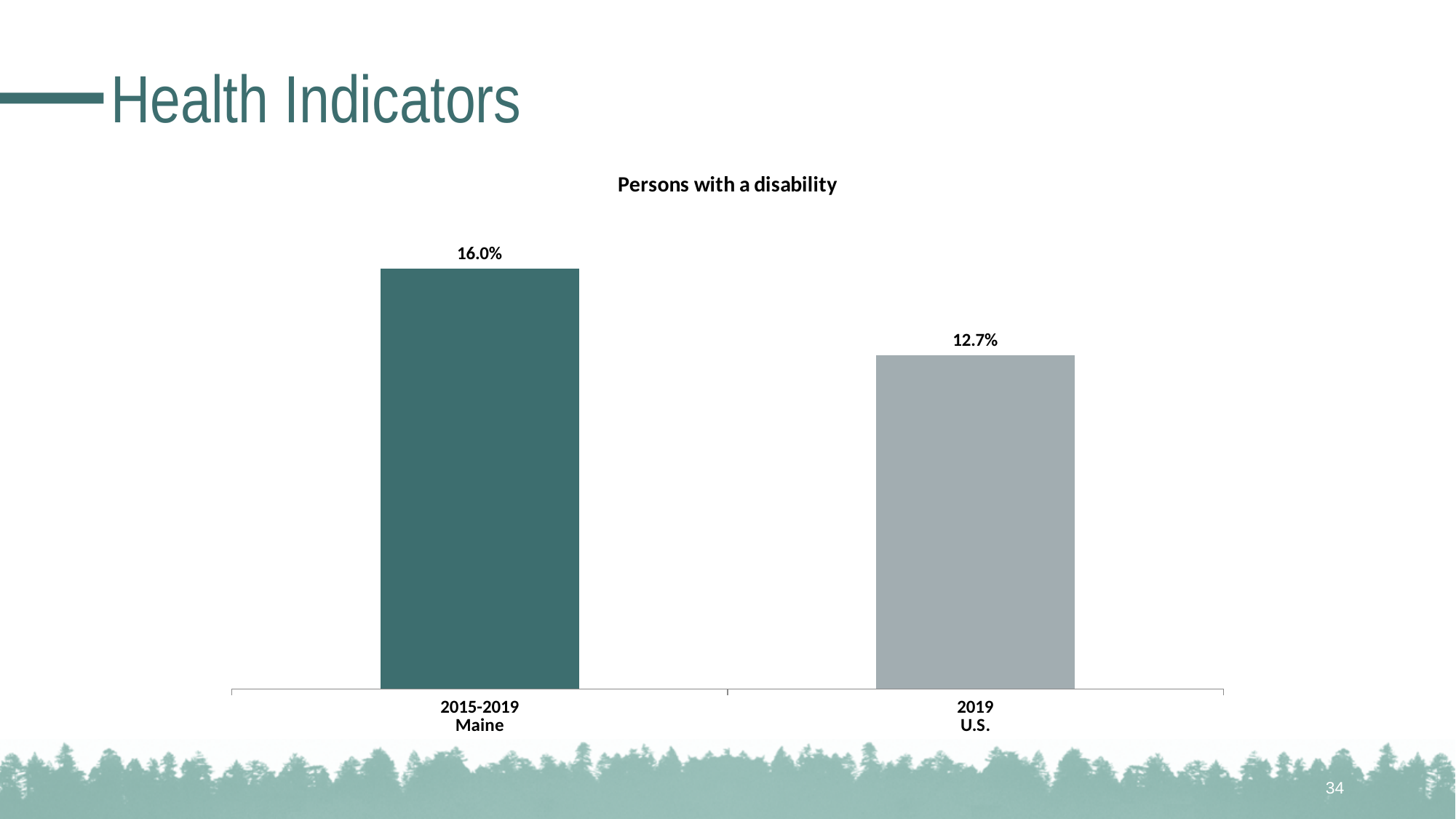
What is the value for Maine (2015-2019) in the Persons with a disability chart? 16.0% What is the value for the U.S. (2019) in the Persons with a disability chart? 12.7% Which category has the lowest value in the chart? U.S. What time period is shown for the Maine bar? 2015-2019 Is the value for Maine larger or smaller than the value for the U.S.? larger What kind of chart is shown on the slide? bar chart Which category has the higher value, Maine or U.S.? Maine How many bars are shown in the chart? 2 What is the difference between the Maine value and the U.S. value? 3.3% What is the title of the chart? Persons with a disability